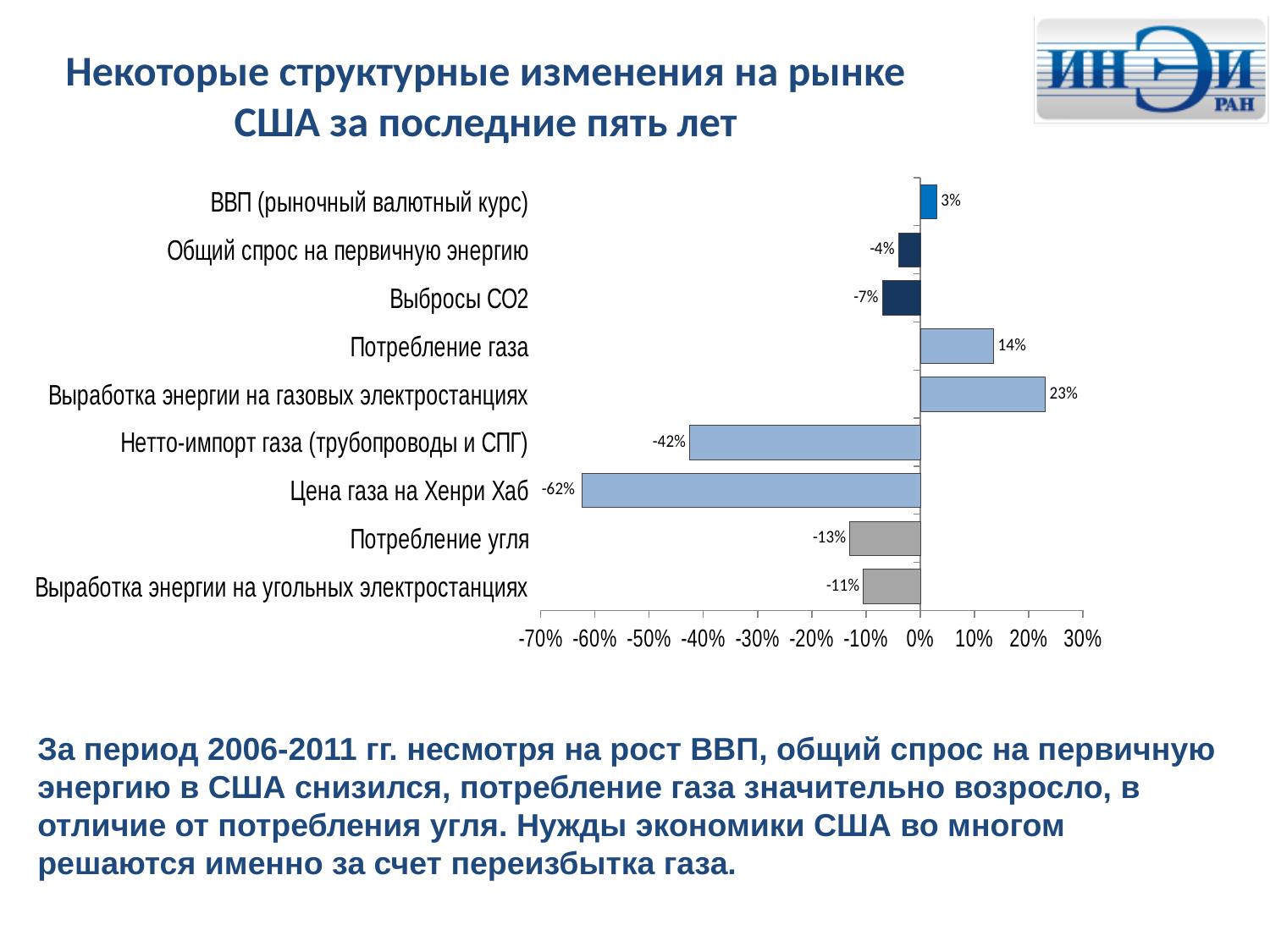
What is the difference between the values for Выработка энергии на газовых электростанциях and Потребление газа? 9 percentage points Is the value for Нетто-импорт газа (трубопроводы и СПГ) greater or less than -30%? less What is the value for ВВП (рыночный валютный курс)? 3% What is the value for Выработка энергии на газовых электростанциях? 23% Which is larger, the value for Потребление газа or the value for ВВП (рыночный валютный курс)? Потребление газа Which category has the highest value? Выработка энергии на газовых электростанциях What is the value for Потребление угля? -13% What kind of chart is shown on the slide? Bar chart What is the value for Выбросы CO2? -7% What is the value for Цена газа на Хенри Хаб? -62% How many categories are shown in the chart? 9 Which category has the lowest value? Цена газа на Хенри Хаб